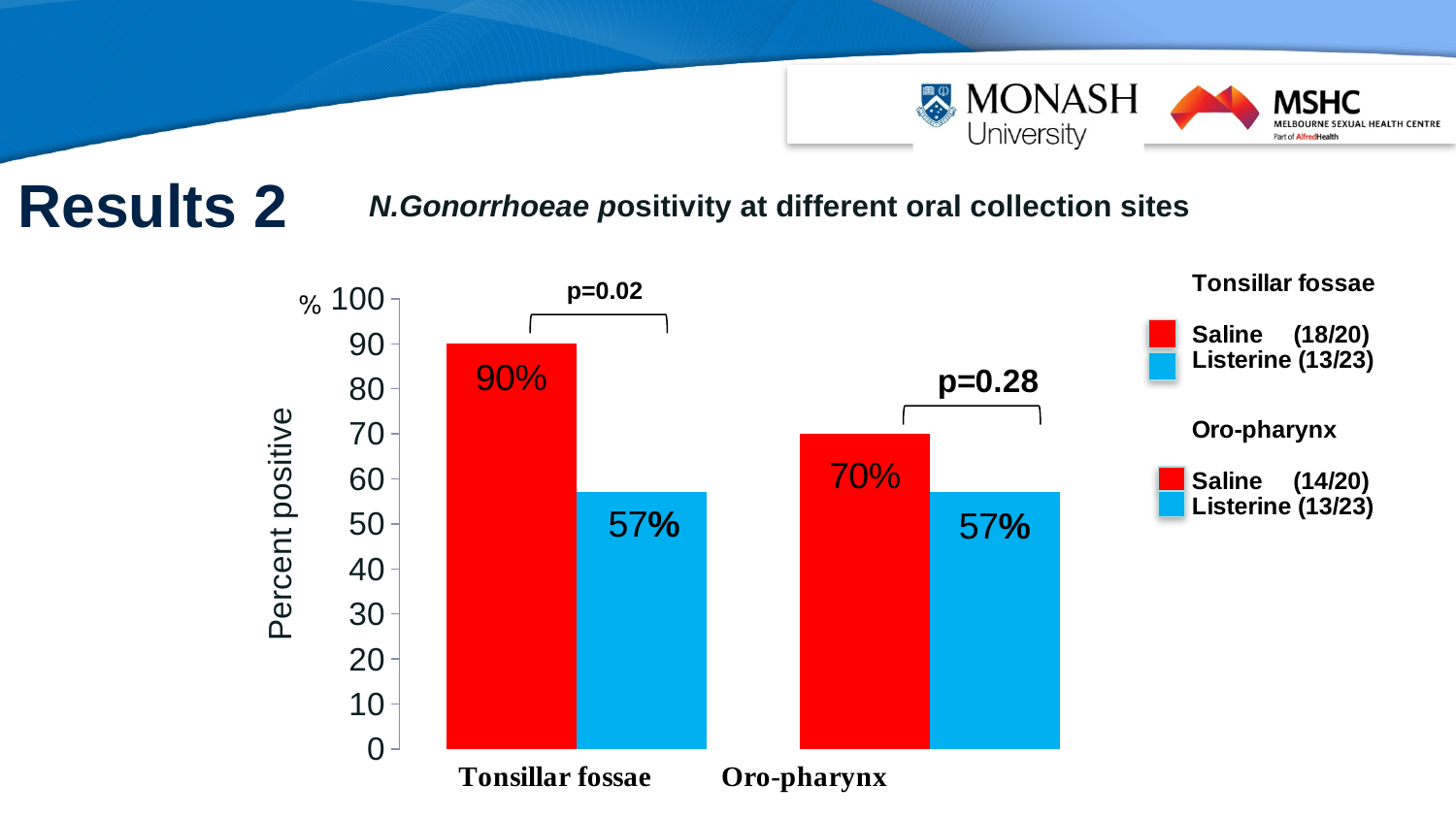
Which is larger: Saline at Tonsillar fossae or Saline at Oro-pharynx? Saline at Tonsillar fossae What p-value is shown for the comparison at the Tonsillar fossae site? p=0.02 Which bar has the highest percent positive? Saline, Tonsillar fossae What is the percent positive for Saline at the Oro-pharynx site? 70% What is the difference in percent positive between Saline and Listerine at the Tonsillar fossae site? 33% What is the difference in percent positive between Saline and Listerine at the Oro-pharynx site? 13% How many collection sites are shown on the x axis? 2 What is the title of the chart? N.Gonorrhoeae positivity at different oral collection sites Is the value for Listerine at Tonsillar fossae greater or less than 60? less What is the percent positive for Saline at the Tonsillar fossae site? 90% What is the percent positive for Listerine at the Oro-pharynx site? 57% What kind of chart is shown on the slide? Bar chart